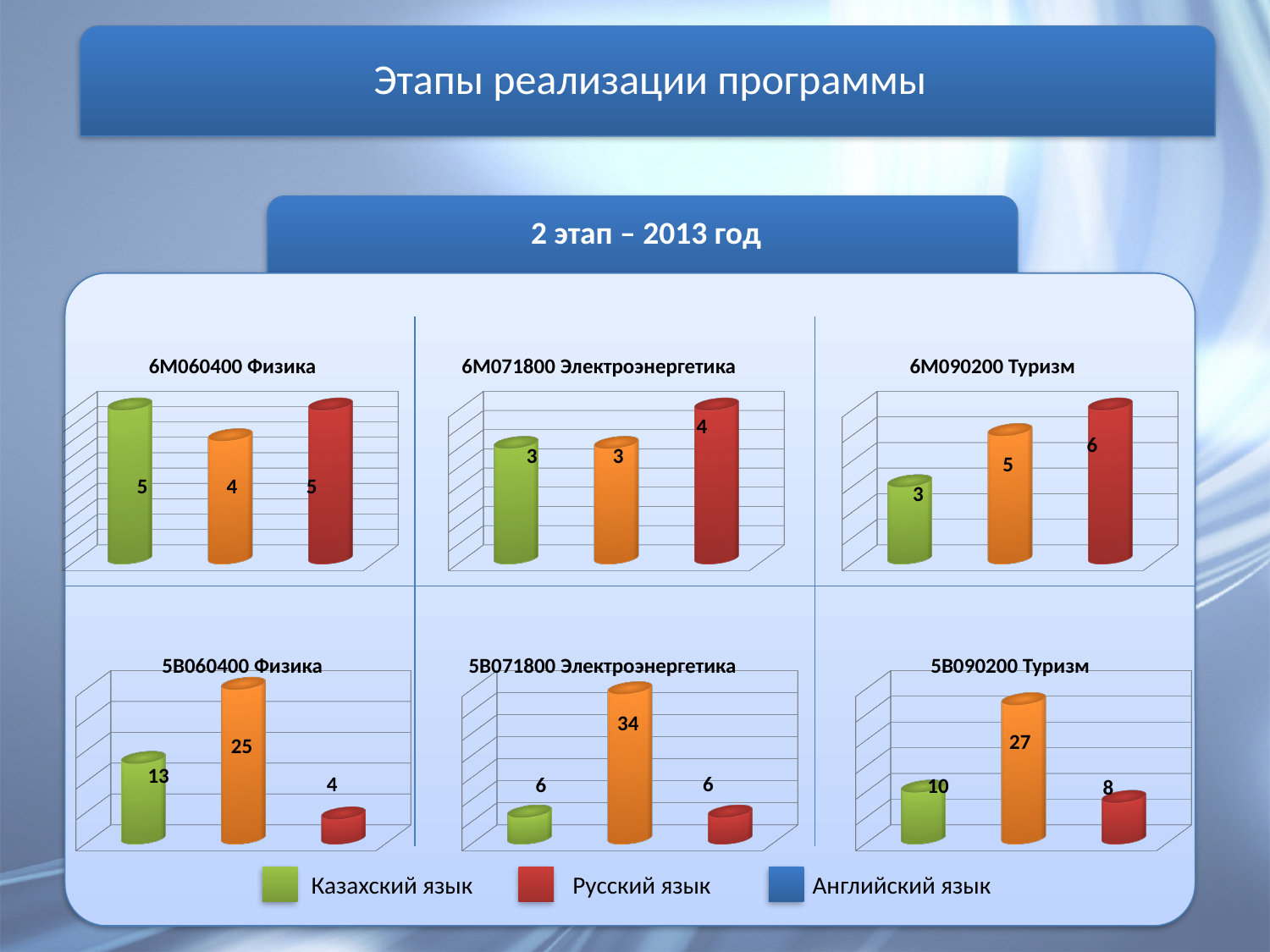
In the "5B071800 Электроэнергетика" chart, what is the value of the orange bar? 34 In the "6M060400 Физика" chart, what is the value of the orange bar? 4 In the "5B060400 Физика" chart, which bar has the highest value? the orange bar (25) In the "5B090200 Туризм" chart, what is the difference between the orange bar and the green bar? 17 In the "5B071800 Электроэнергетика" chart, what is the total of all three bars? 46 In the "6M090200 Туризм" chart, what is the value of the red bar? 6 In the "5B090200 Туризм" chart, which bar has the lowest value? the red bar (8) In the "5B060400 Физика" chart, what is the difference between the orange bar and the green bar? 12 Which language does the green entry in the legend at the bottom of the slide represent? Казахский язык How many bars are shown in the "6M071800 Электроэнергетика" chart? 3 In the "6M090200 Туризм" chart, which is larger, the green bar or the orange bar? the orange bar What kind of chart is the "5B090200 Туризм" chart? bar chart